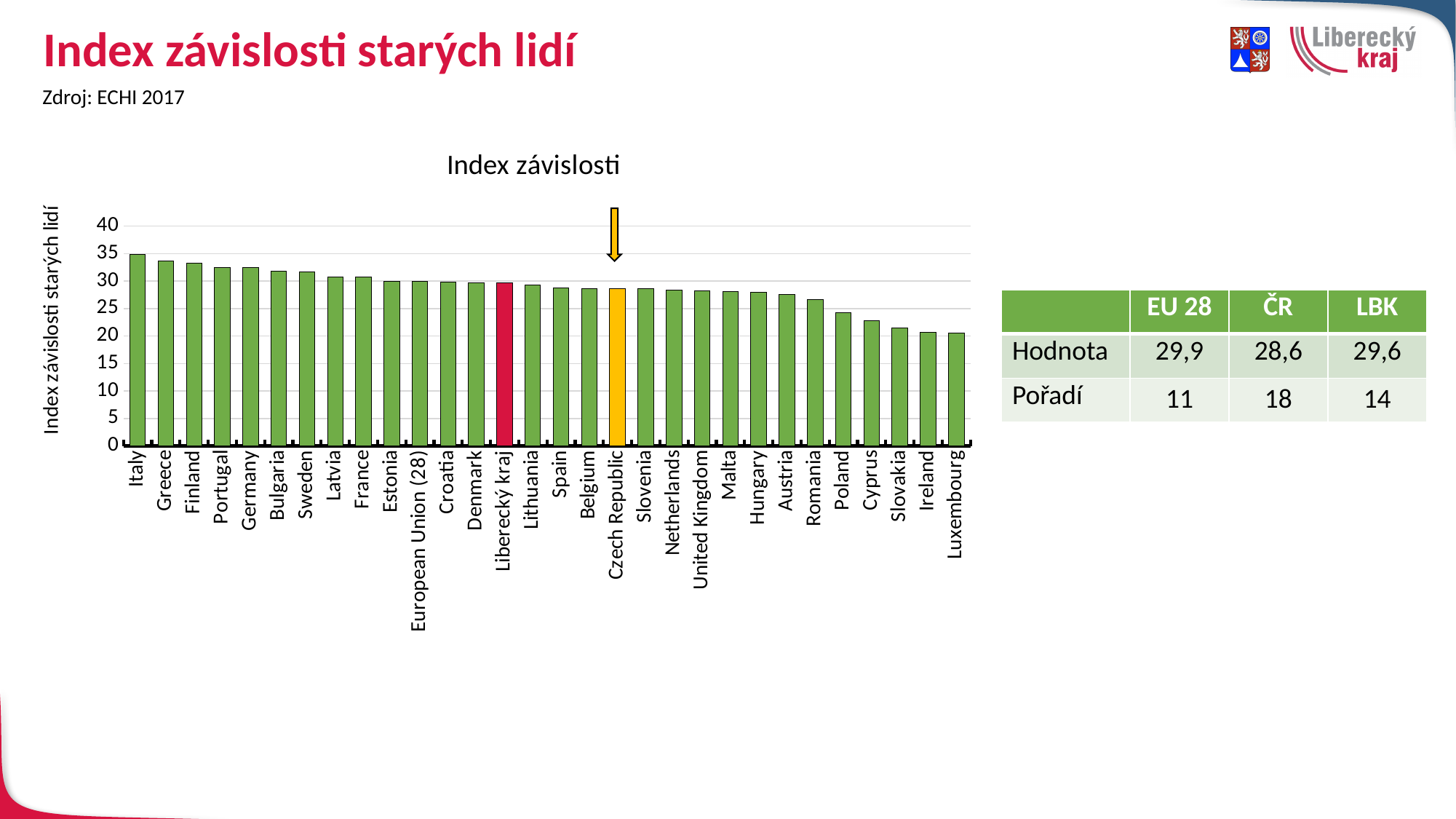
What is the title of the chart? Index závislosti How many categories (bars) are plotted in the chart? 30 What type of chart is shown on the slide? bar chart Is the value for Luxembourg greater or less than 25? less Which category has the highest value in the chart? Italy What colour is the bar for Czech Republic in the chart? yellow Do the values rise or fall from left to right along the x axis? fall According to the table on the slide, what is the difference between the value for EU 28 and the value for ČR? 1,3 According to the table on the slide, what is the value (Hodnota) for the Czech Republic (ČR)? 28,6 Is the value for Italy greater or less than 30? greater Which has the larger value, Greece or Cyprus? Greece